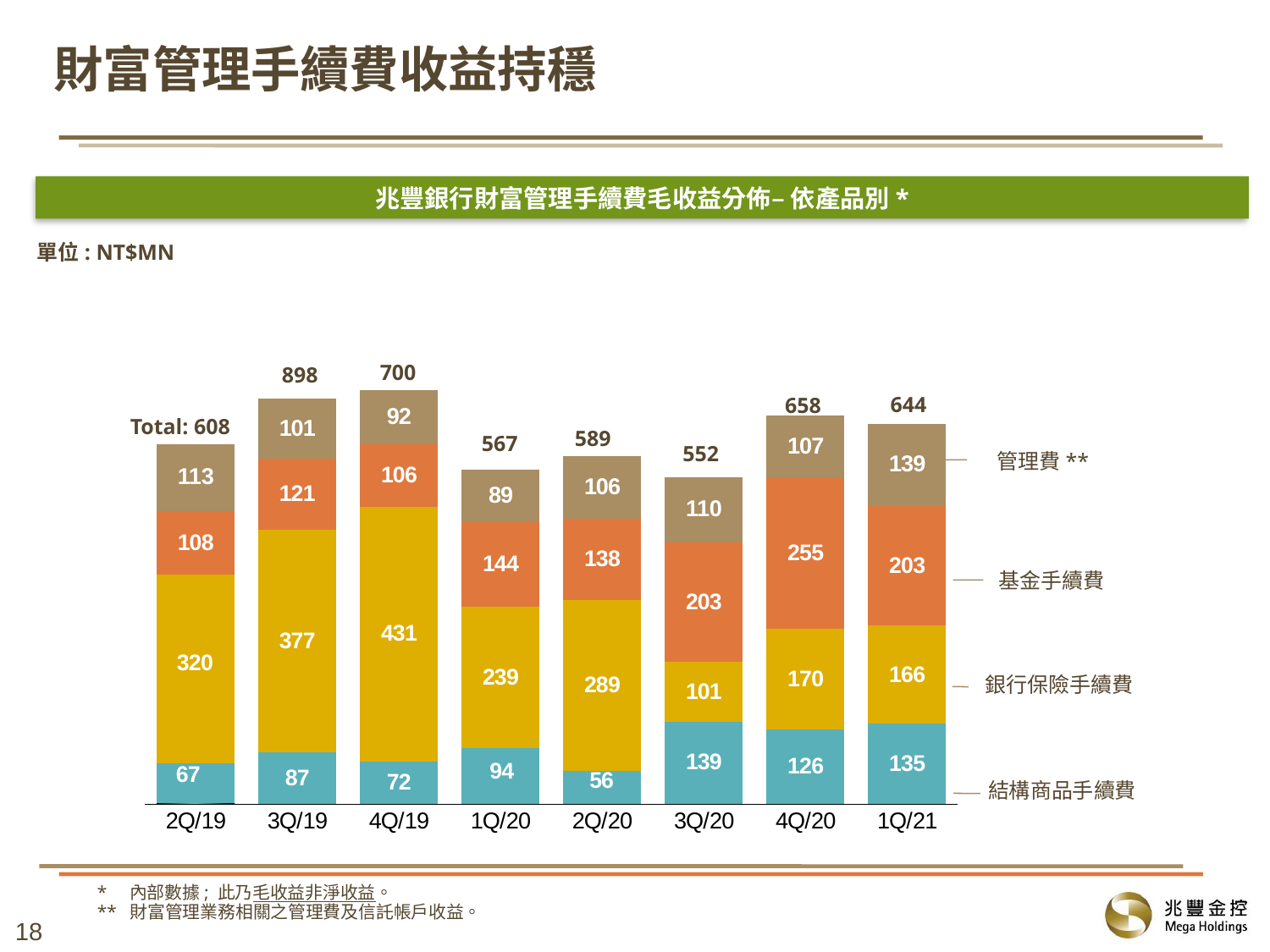
What is the total for 3Q/19? 898 What is the difference between the 基金手續費 values for 4Q/20 and 1Q/21? 52 How many series does the chart show? 4 What is the 銀行保險手續費 value for 4Q/19? 431 What kind of chart is shown on the slide? Stacked bar chart What is the 基金手續費 value for 4Q/20? 255 How many quarters are shown on the x axis? 8 What is the 結構商品手續費 value for 2Q/20? 56 What is the 管理費 value for 1Q/21? 139 Which is larger, the 銀行保險手續費 value for 3Q/20 or for 4Q/20? 4Q/20 Which quarter has the lowest total? 3Q/20 Which quarter has the highest total? 3Q/19